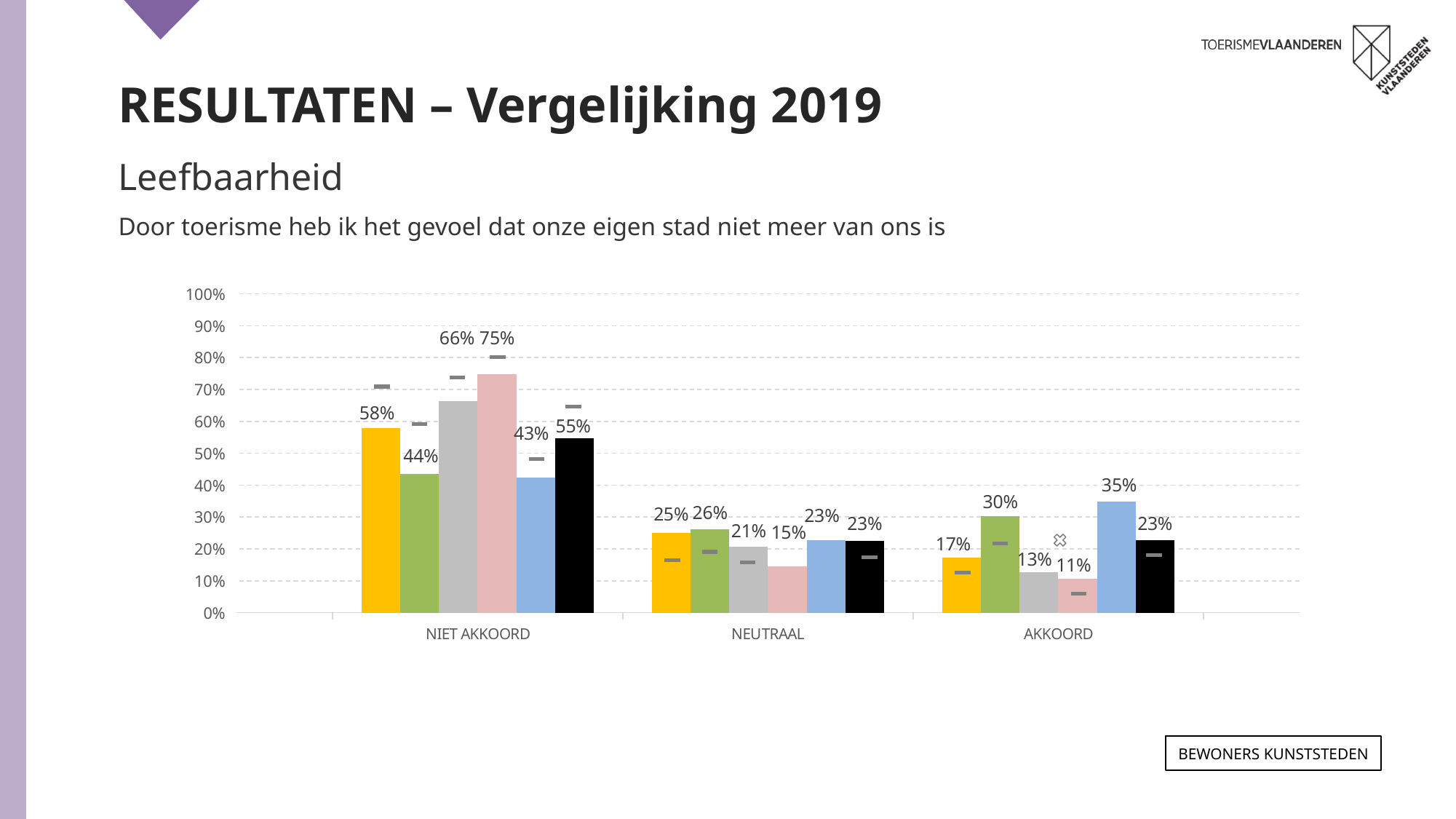
What is the difference between the pink bar and the blue bar in the NIET AKKOORD category? 32 percentage points Is the value of the grey bar in the NIET AKKOORD category greater or less than 60%? greater How many categories are shown on the x axis of the chart? 3 Which bar is the highest in the NIET AKKOORD category? the pink bar (75%) What is the value of the blue bar in the AKKOORD category? 35% Which is larger in the AKKOORD category: the green bar or the yellow bar? the green bar What is the value of the pink bar in the NEUTRAAL category? 15% What type of chart is shown on the slide? bar chart Which bar is the lowest in the AKKOORD category? the pink bar (11%) What statement is the chart about, according to the text above it? Door toerisme heb ik het gevoel dat onze eigen stad niet meer van ons is What is the value of the yellow bar in the NIET AKKOORD category? 58% What is the value of the pink bar in the NIET AKKOORD category? 75%